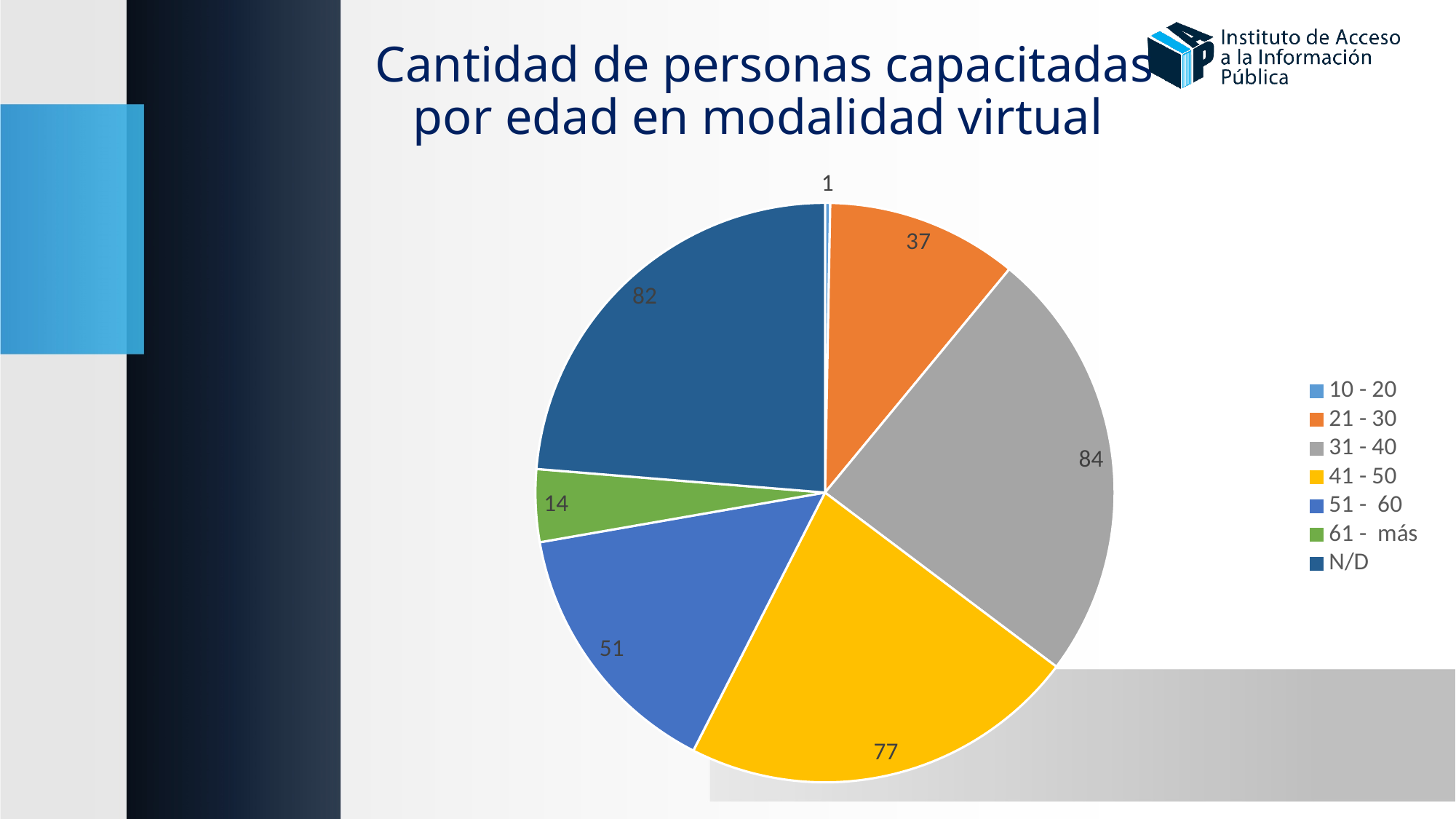
What is the total of all the values shown in the pie chart? 346 What type of chart is shown on the slide? Pie chart Which category has the smallest slice of the pie? 10 - 20 How many people aged 31 - 40 were trained in the virtual modality? 84 What is the value for the 41 - 50 age group? 77 Which is larger, the value for 51 - 60 or the value for 21 - 30? 51 - 60 What is the difference between the values for 31 - 40 and 21 - 30? 47 What is the value for the 61 - más age group? 14 Which age category has the largest slice of the pie? 31 - 40 How many categories does the legend list? 7 What is the title of the chart on the slide? Cantidad de personas capacitadas por edad en modalidad virtual What is the value for the N/D category? 82